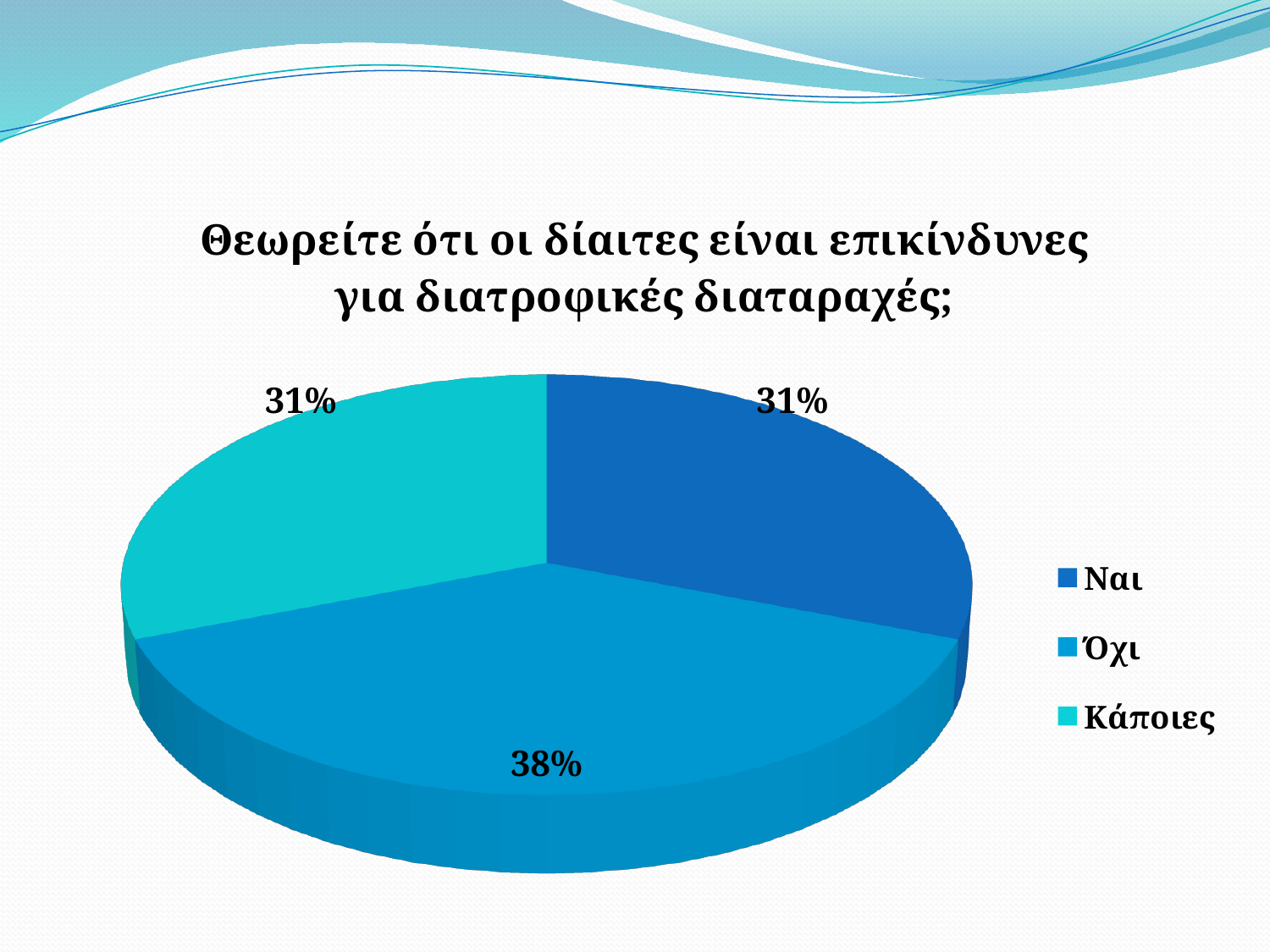
How many entries does the legend list? 3 What percentage of the pie is the "Κάποιες" slice? 31% What kind of chart is shown on the slide? pie chart What percentage of the pie is the "Ναι" slice? 31% Which is larger, the "Όχι" slice or the "Κάποιες" slice? Όχι Which category has the largest slice of the pie? Όχι What is the title of the chart? Θεωρείτε ότι οι δίαιτες είναι επικίνδυνες για διατροφικές διαταραχές; Which legend entry is shown in the lightest (teal) colour? Κάποιες What is the difference in percentage points between the "Όχι" slice and the "Ναι" slice? 7 Is the "Όχι" slice greater or less than 50% of the pie? less How many slices does the pie chart have? 3 What percentage of the pie is the "Όχι" slice? 38%